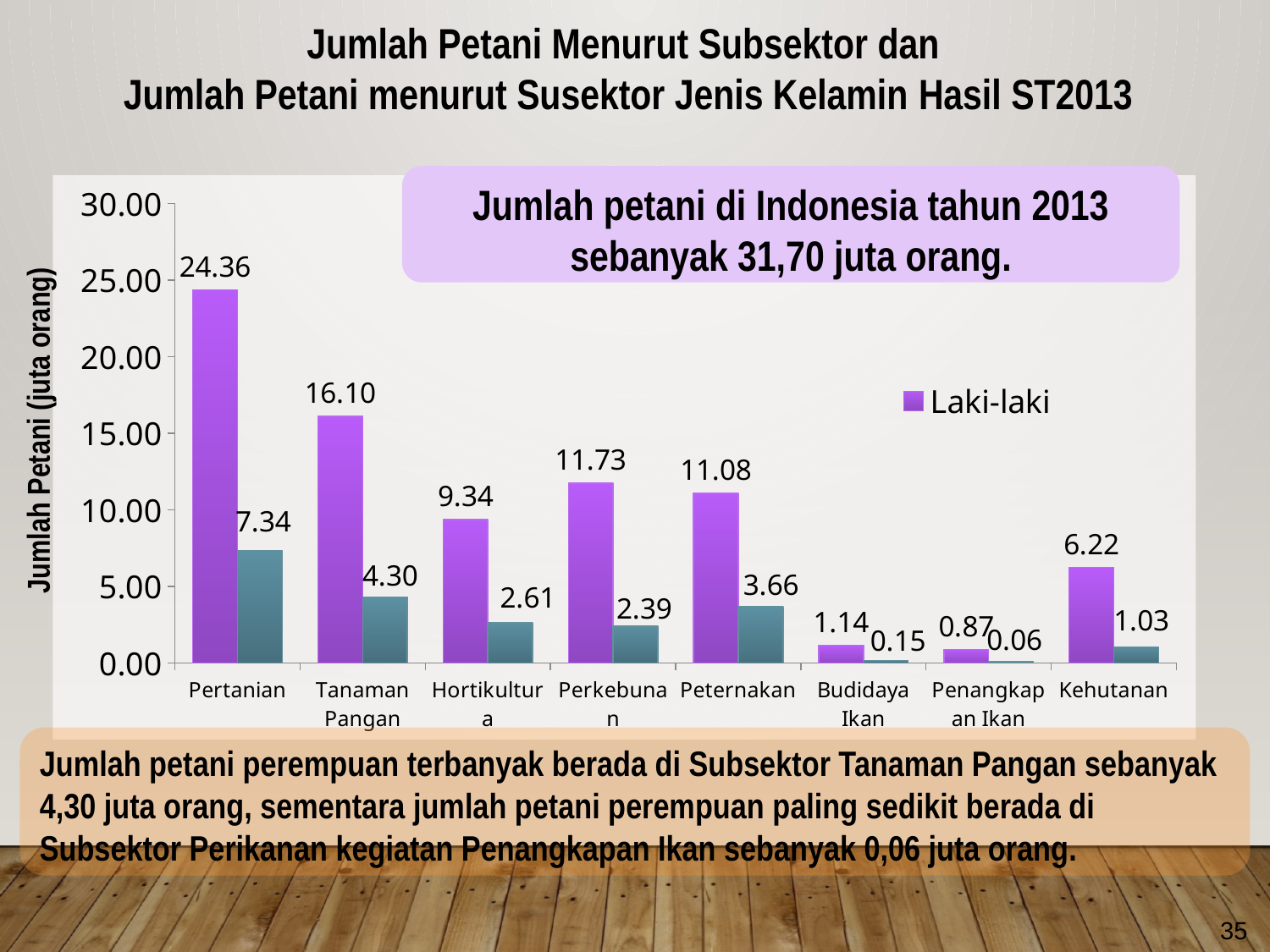
Which has the larger Laki-laki value, Perkebunan or Peternakan? Perkebunan What is the Laki-laki value for Kehutanan? 6.22 Which subsector has the highest Laki-laki value? Pertanian How many subsector categories are shown on the x axis? 8 What is the difference between the Laki-laki value and the teal series value for Hortikultura? 6.73 Which subsector has the lowest Laki-laki value? Penangkapan Ikan What is the title of the y axis? Jumlah Petani (juta orang) What is the Laki-laki value for Pertanian? 24.36 What is the difference between the Laki-laki value and the teal series value for Pertanian? 17.02 Which subsector has the lowest value in the teal (second) series? Penangkapan Ikan What kind of chart is shown on the slide? Bar chart What is the value of the teal (second) series for Tanaman Pangan? 4.30